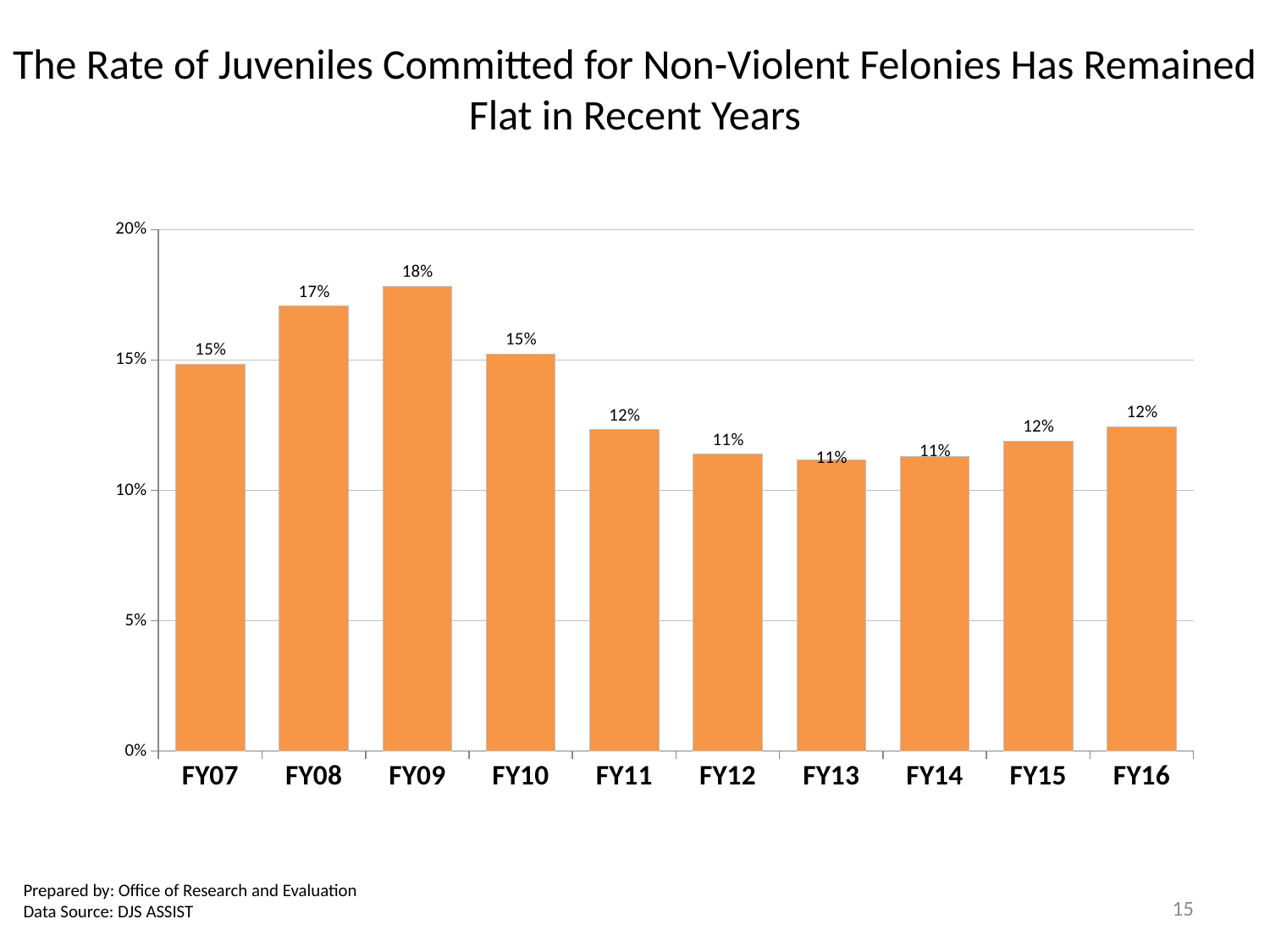
What is the difference between the values for FY08 and FY11? 5% What is the difference between the values for FY09 and FY07? 3% Do the values rise or fall from FY09 to FY13? fall How many fiscal years are shown on the x axis? 10 What is the value for FY09? 18% Is the value for FY10 greater or less than 20%? less Is the value for FY11 greater or less than 10%? greater What is the value for FY16? 12% What is the value for FY13? 11% What kind of chart is shown on the slide? bar chart Which fiscal year has the highest value? FY09 Which is larger, the value for FY08 or the value for FY11? FY08